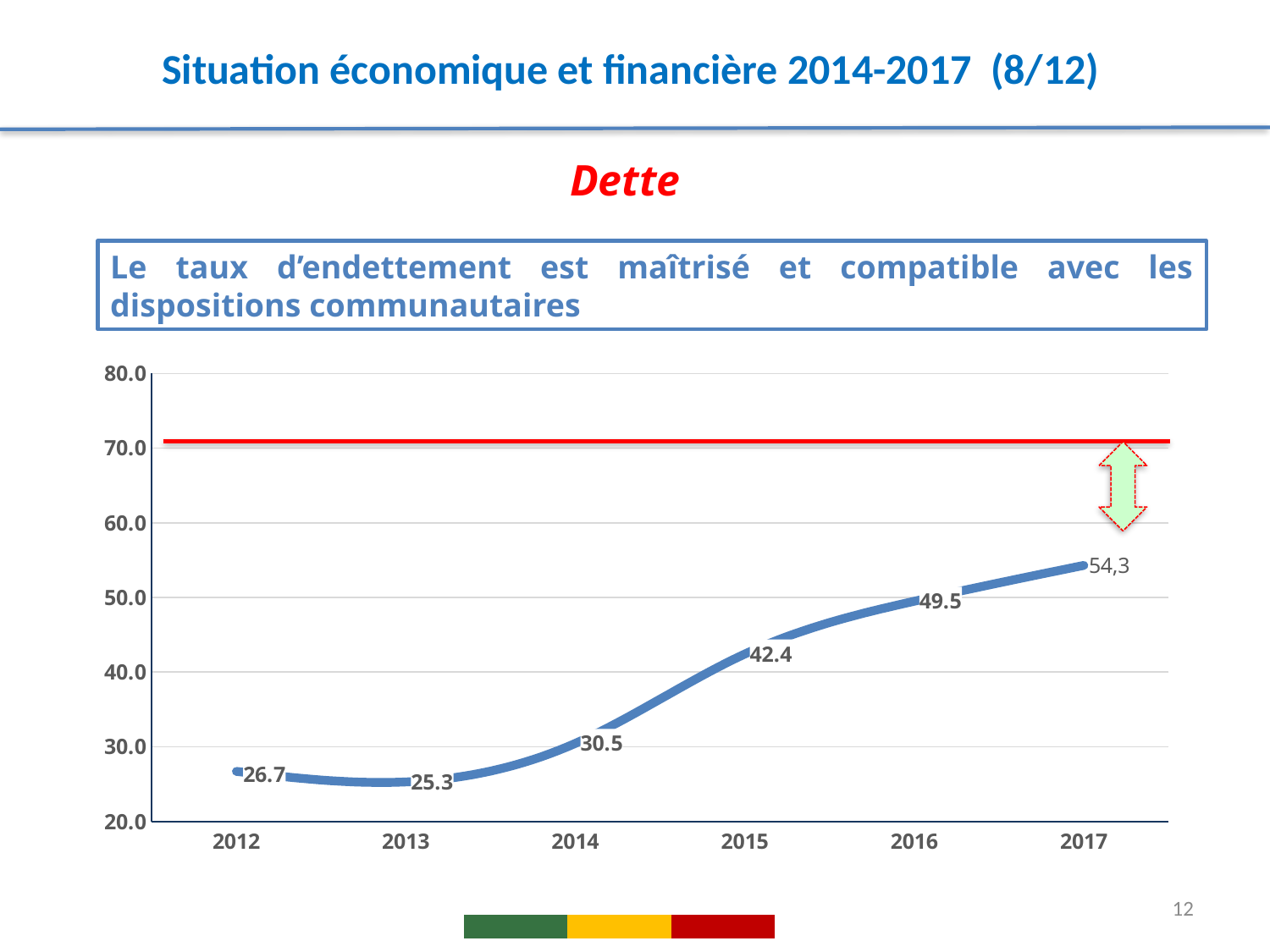
Which year has the lowest value? 2013 What is the title shown above the chart? Dette Which year has the highest value? 2017 Do the values rise or fall from 2014 to 2017? rise How many years are plotted on the chart? 6 What is the value for 2015? 42.4 What is the value for 2012? 26.7 What is the value for 2017? 54,3 Which is larger, the value for 2014 or the value for 2013? 2014 Is the value for 2016 greater or less than 40.0? greater What kind of chart is shown on the slide? line chart What is the difference between the values for 2016 and 2015? 7.1